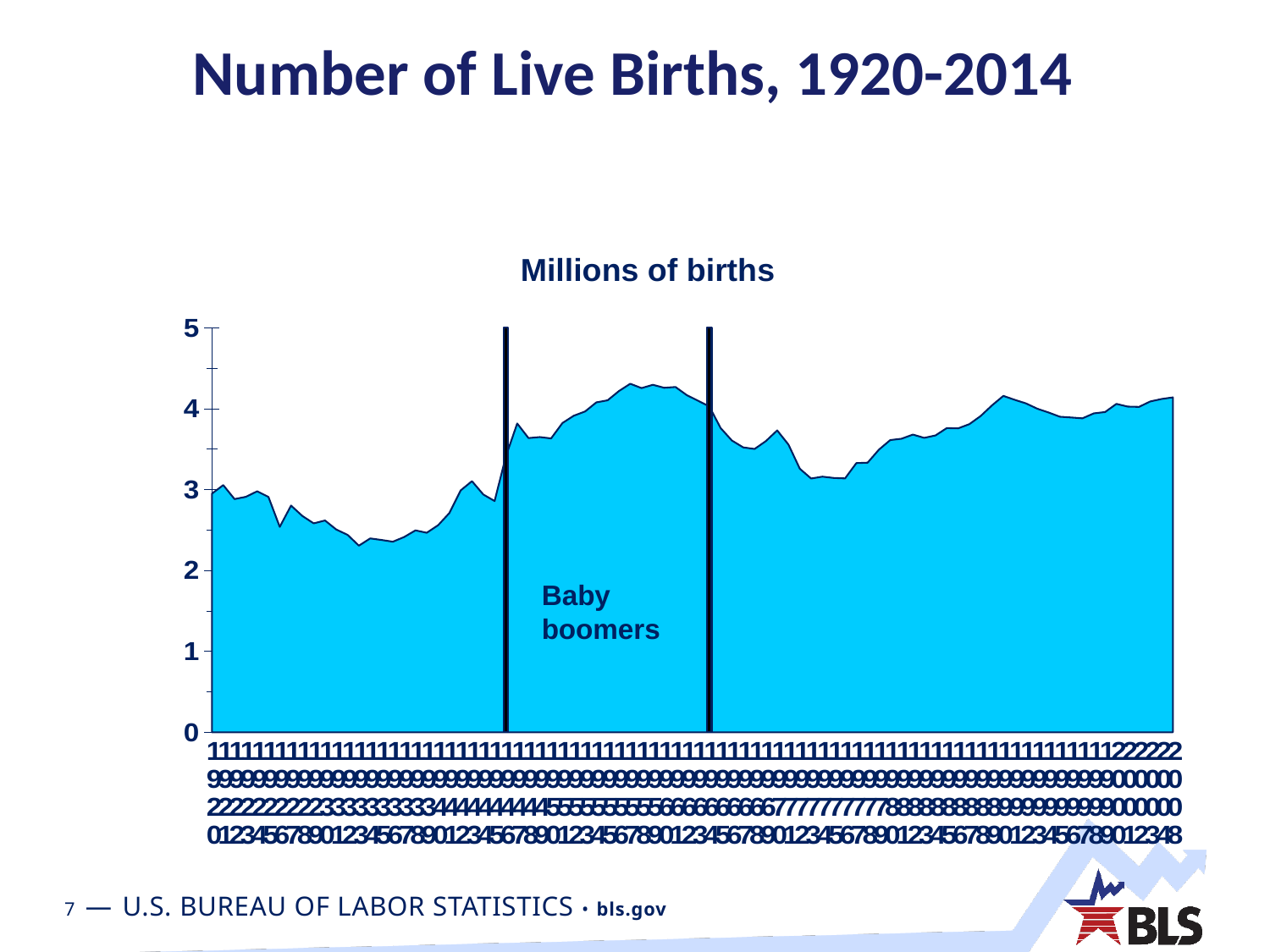
Is the value at the end of the series in 2014 greater or less than 3? greater What unit label is shown above the chart's vertical axis? Millions of births Is the lowest value of the chart, reached in the 1930s, greater or less than 3? less Do the values rise or fall from 1920 to the early 1930s? fall Which period is labelled between the two vertical lines on the chart? Baby boomers What is the highest value shown on the vertical axis of the chart? 5 Do the values generally rise or fall across the period marked 'Baby boomers'? rise Is the value at the start of the series in 1920 greater or less than 2? greater What kind of chart is shown on the slide? area chart Do the values rise or fall from the end of the baby boomer period into the mid-1970s? fall